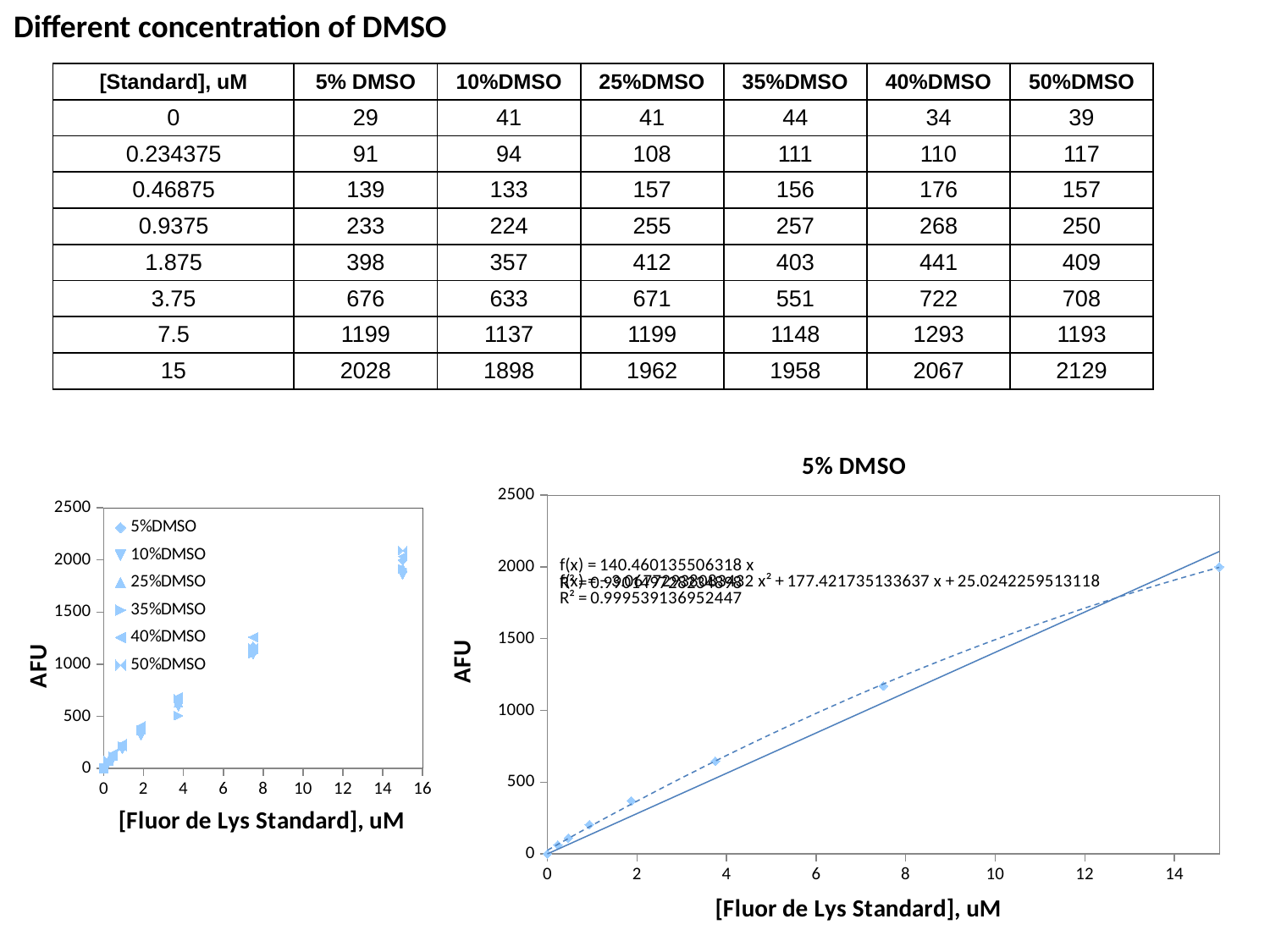
In the left chart, are the AFU values for all series at 3.75 uM greater or less than 1000? less What is the y-axis title of the left chart? AFU What kind of chart is the chart titled "5% DMSO"? scatter chart In the "5% DMSO" chart, is the AFU value at 7.5 uM greater or less than 1000? greater What is the title of the chart on the right? 5% DMSO How many data points are plotted in the "5% DMSO" chart? 8 In the "5% DMSO" chart, is the AFU value at 1.875 uM greater or less than 500? less In the "5% DMSO" chart, do the AFU values rise or fall as the standard concentration increases? rise How many series does the legend of the left chart list? 6